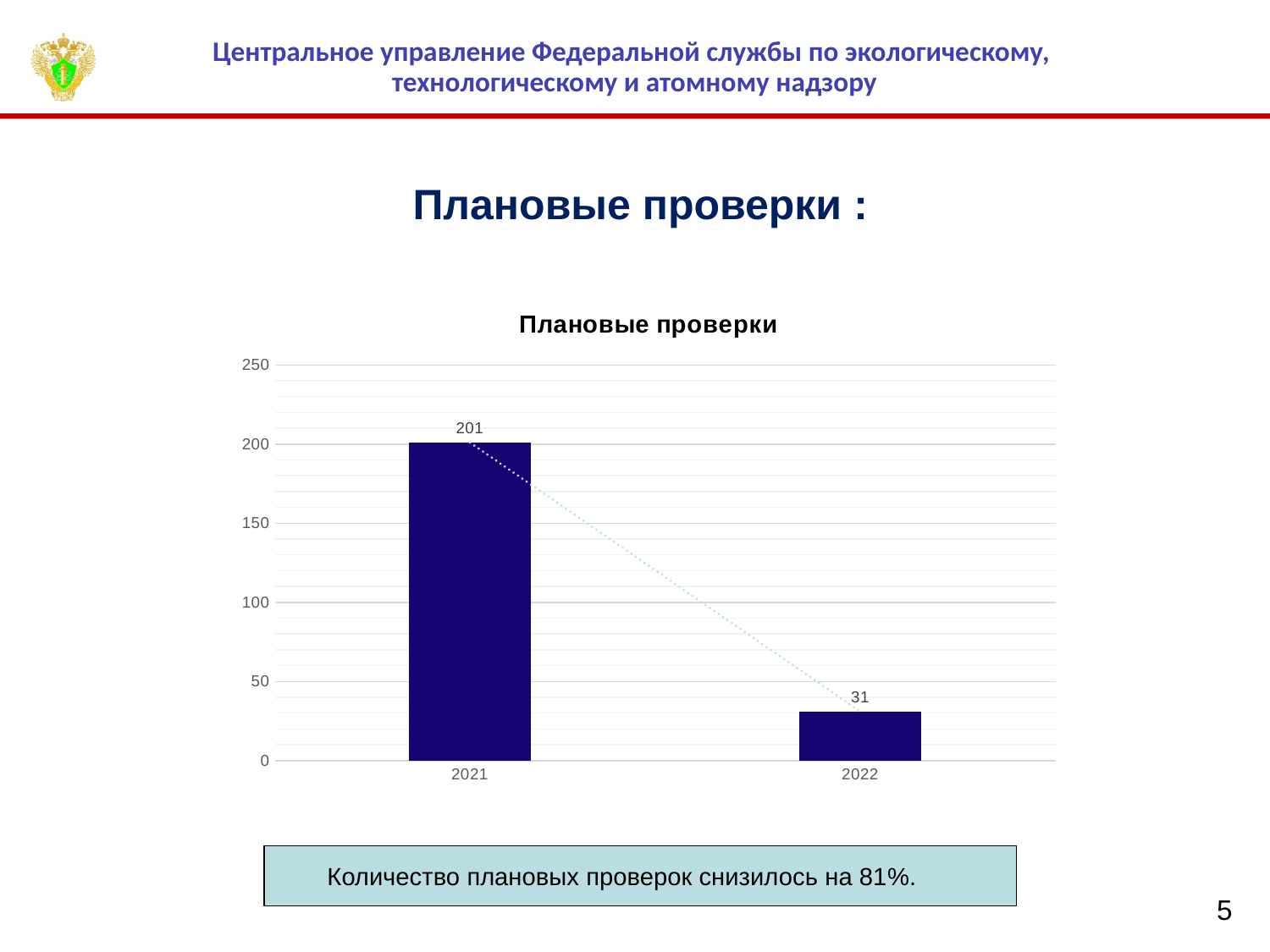
Do the values rise or fall from 2021 to 2022? fall Is the value for 2021 greater or less than 150? greater How many categories are shown on the x axis? 2 What is the difference between the values for 2021 and 2022? 170 What is the value for 2022? 31 What kind of chart is shown? bar chart What is the title of the chart? Плановые проверки Which year has the highest value? 2021 Which is larger, the value for 2021 or the value for 2022? 2021 Is the value for 2022 greater or less than 50? less What is the value for 2021? 201 Which year has the lowest value? 2022